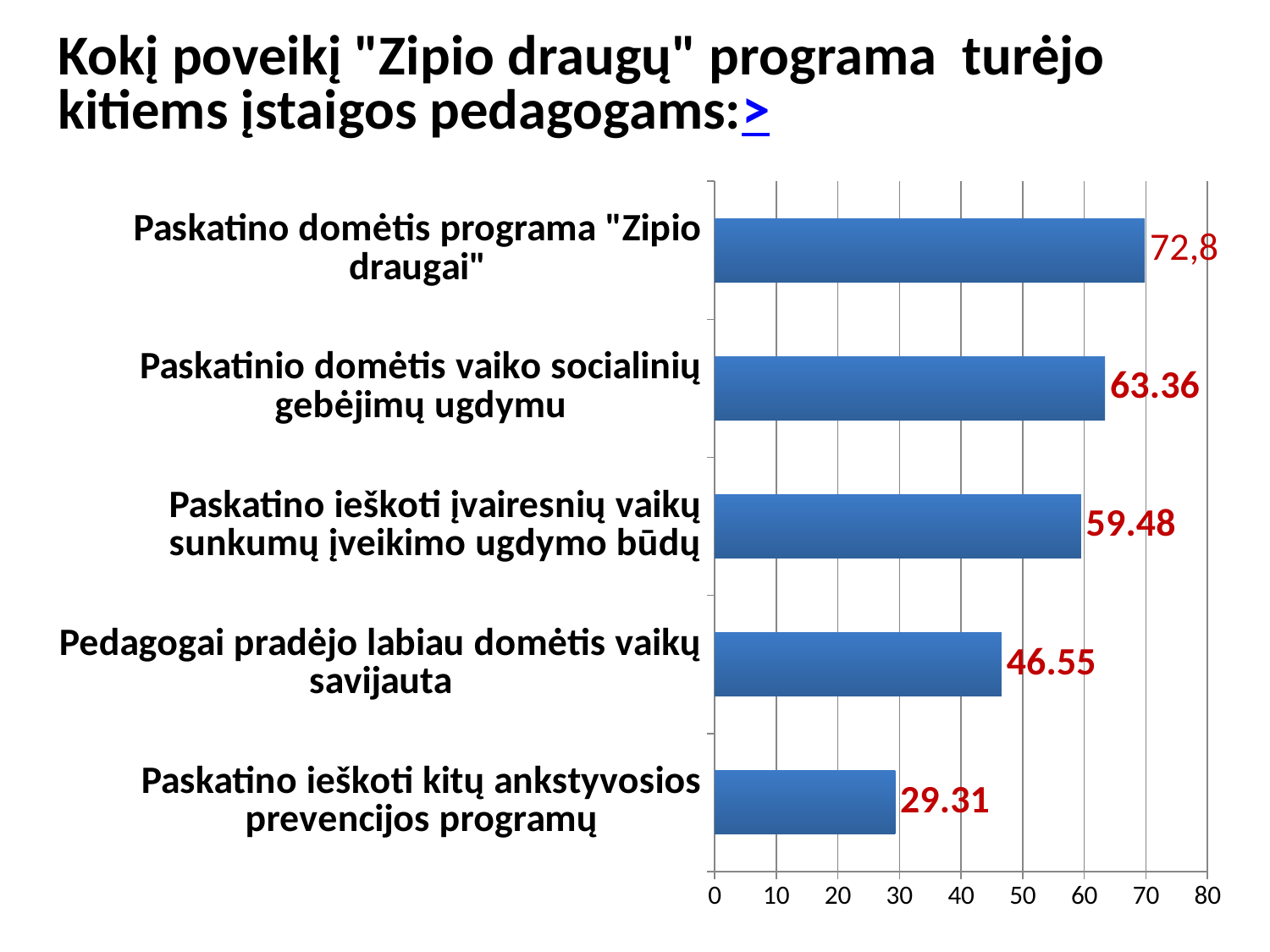
Which category has the highest value? Paskatino domėtis programa "Zipio draugai" What value is shown for "Paskatinio domėtis vaiko socialinių gebėjimų ugdymu"? 63.36 How many categories are shown in the chart? 5 What is the difference between the values for "Pedagogai pradėjo labiau domėtis vaikų savijauta" and "Paskatino ieškoti kitų ankstyvosios prevencijos programų"? 17.24 What is the difference between the values for "Paskatinio domėtis vaiko socialinių gebėjimų ugdymu" and "Paskatino ieškoti įvairesnių vaikų sunkumų įveikimo ugdymo būdų"? 3.88 Which is larger: the value for "Paskatino ieškoti įvairesnių vaikų sunkumų įveikimo ugdymo būdų" or for "Pedagogai pradėjo labiau domėtis vaikų savijauta"? Paskatino ieškoti įvairesnių vaikų sunkumų įveikimo ugdymo būdų Which category has the lowest value? Paskatino ieškoti kitų ankstyvosios prevencijos programų Is the value for "Paskatino ieškoti kitų ankstyvosios prevencijos programų" greater or less than 40? less What value is shown for "Pedagogai pradėjo labiau domėtis vaikų savijauta"? 46.55 What kind of chart is shown on the slide? bar chart What value is shown for "Paskatino domėtis programa "Zipio draugai""? 72,8 What value is shown for "Paskatino ieškoti kitų ankstyvosios prevencijos programų"? 29.31